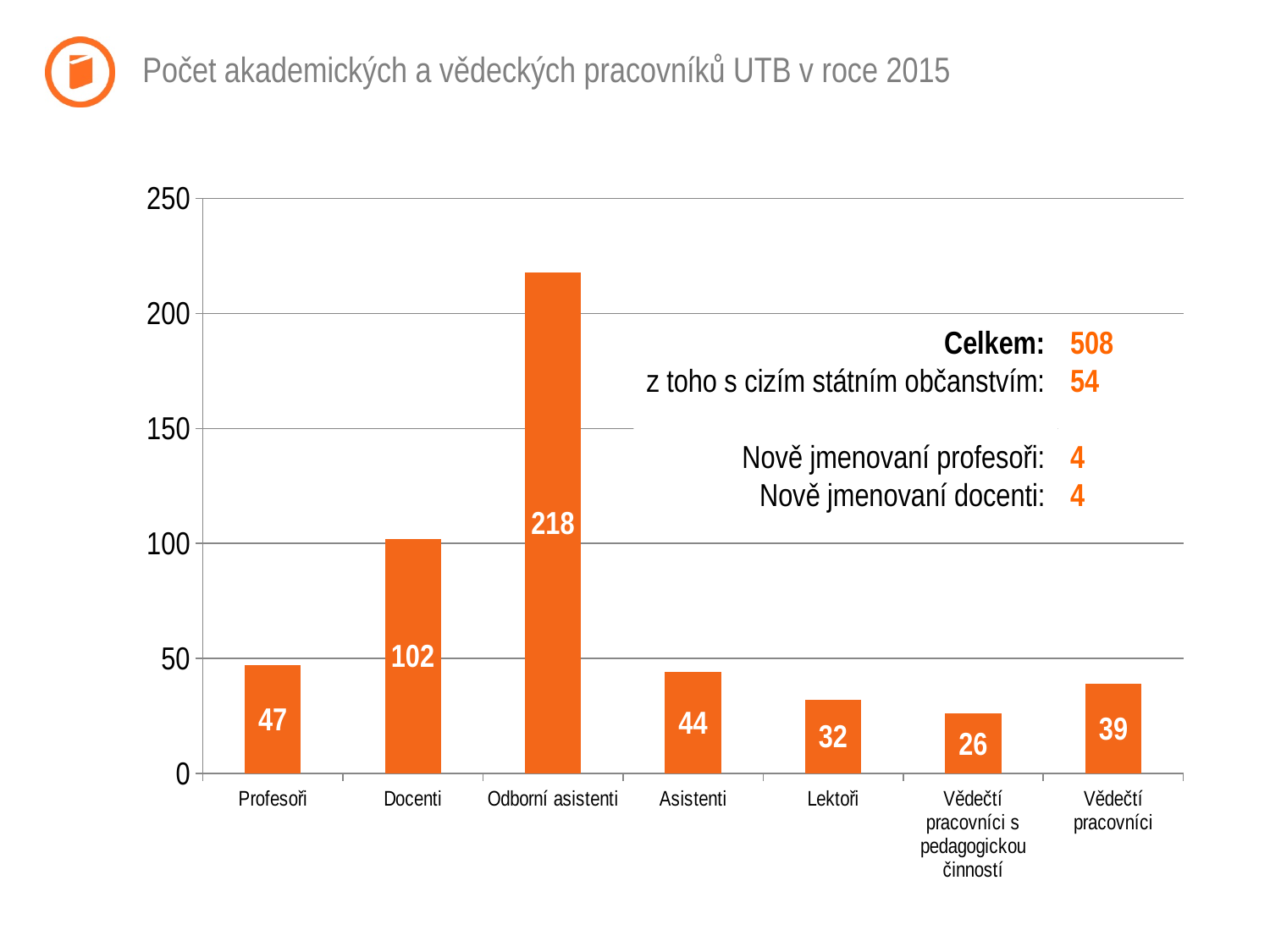
What is the difference between the values for Docenti and Profesoři? 55 Is the value for Docenti greater or less than 100? greater Which is larger, the value for Asistenti or the value for Vědečtí pracovníci? Asistenti What colour are the bars in the chart? orange What is the value for Lektoři? 32 How many categories are shown on the x axis? 7 Which category has the lowest value? Vědečtí pracovníci s pedagogickou činností Which category has the highest value? Odborní asistenti What is the value for Vědečtí pracovníci s pedagogickou činností? 26 What is the title of the slide? Počet akademických a vědeckých pracovníků UTB v roce 2015 What is the value for Odborní asistenti? 218 What kind of chart is shown on the slide? bar chart